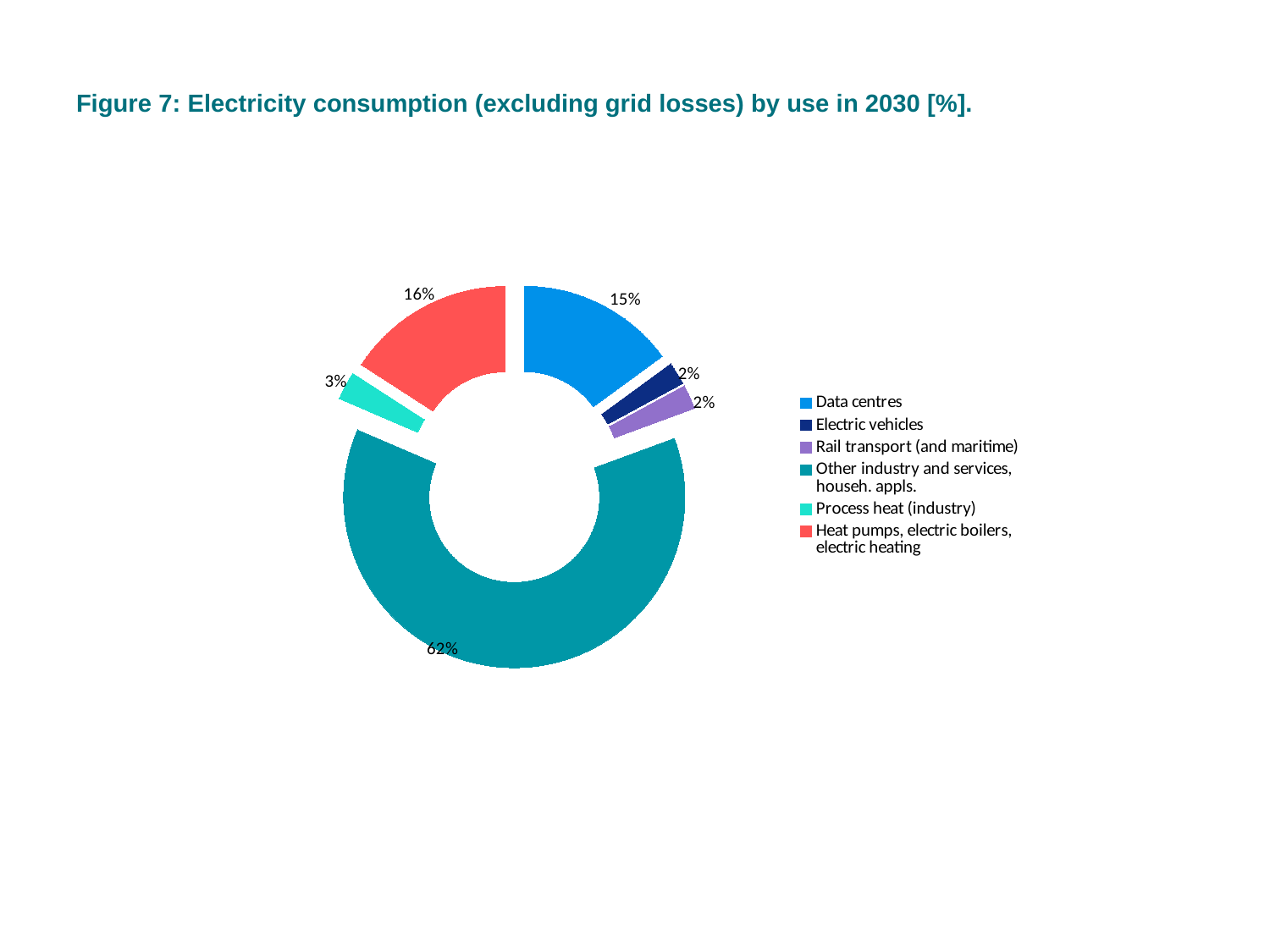
How many categories does the chart show? 6 Which has a larger share: Data centres or Process heat (industry)? Data centres What share of electricity consumption in 2030 is attributed to Heat pumps, electric boilers, electric heating? 16% What share of electricity consumption in 2030 is attributed to Other industry and services, househ. appls.? 62% What share of electricity consumption in 2030 is attributed to Electric vehicles? 2% What share of electricity consumption in 2030 is attributed to Data centres? 15% What is the difference in share between Heat pumps, electric boilers, electric heating and Data centres? 1% Which use accounts for the largest share of electricity consumption in 2030? Other industry and services, househ. appls. What is the title of the chart? Figure 7: Electricity consumption (excluding grid losses) by use in 2030 [%]. What share of electricity consumption in 2030 is attributed to Process heat (industry)? 3% What is the difference in share between Other industry and services, househ. appls. and Data centres? 47% What kind of chart is shown on the slide? Pie chart (doughnut)